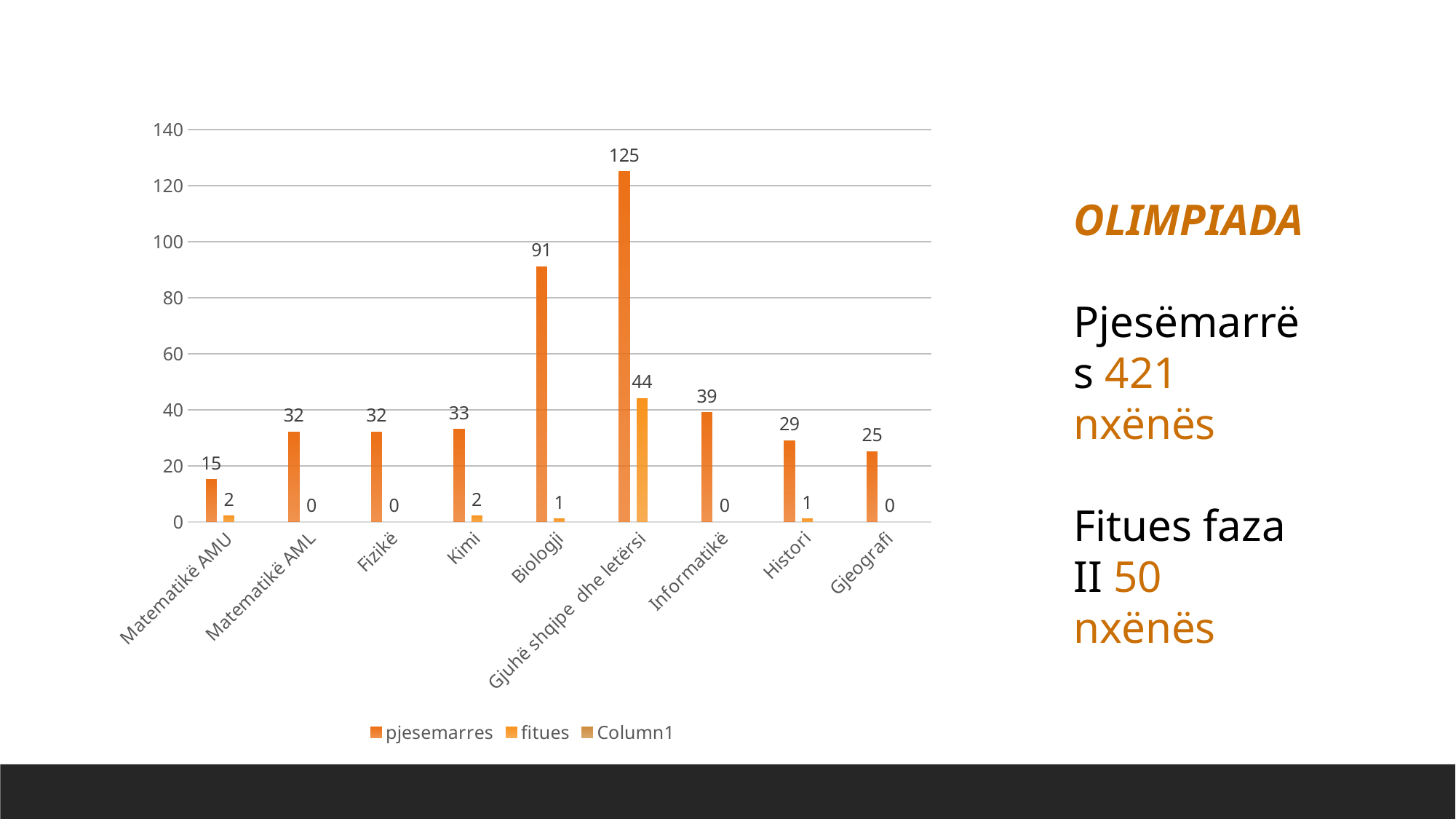
How many categories are shown on the x axis? 9 Which category has the lowest pjesemarres value? Matematikë AMU What kind of chart is shown on the slide? bar chart What is the fitues value for Gjuhë shqipe dhe letërsi? 44 Which category has the highest pjesemarres value? Gjuhë shqipe dhe letërsi What is the pjesemarres value for Biologji? 91 What is the difference between the pjesemarres values for Gjuhë shqipe dhe letërsi and Biologji? 34 How many series does the legend list? 3 What is the pjesemarres value for Informatikë? 39 What is the fitues value for Kimi? 2 Which is larger, the pjesemarres value for Histori or for Gjeografi? Histori Is the pjesemarres value for Biologji greater or less than 80? greater